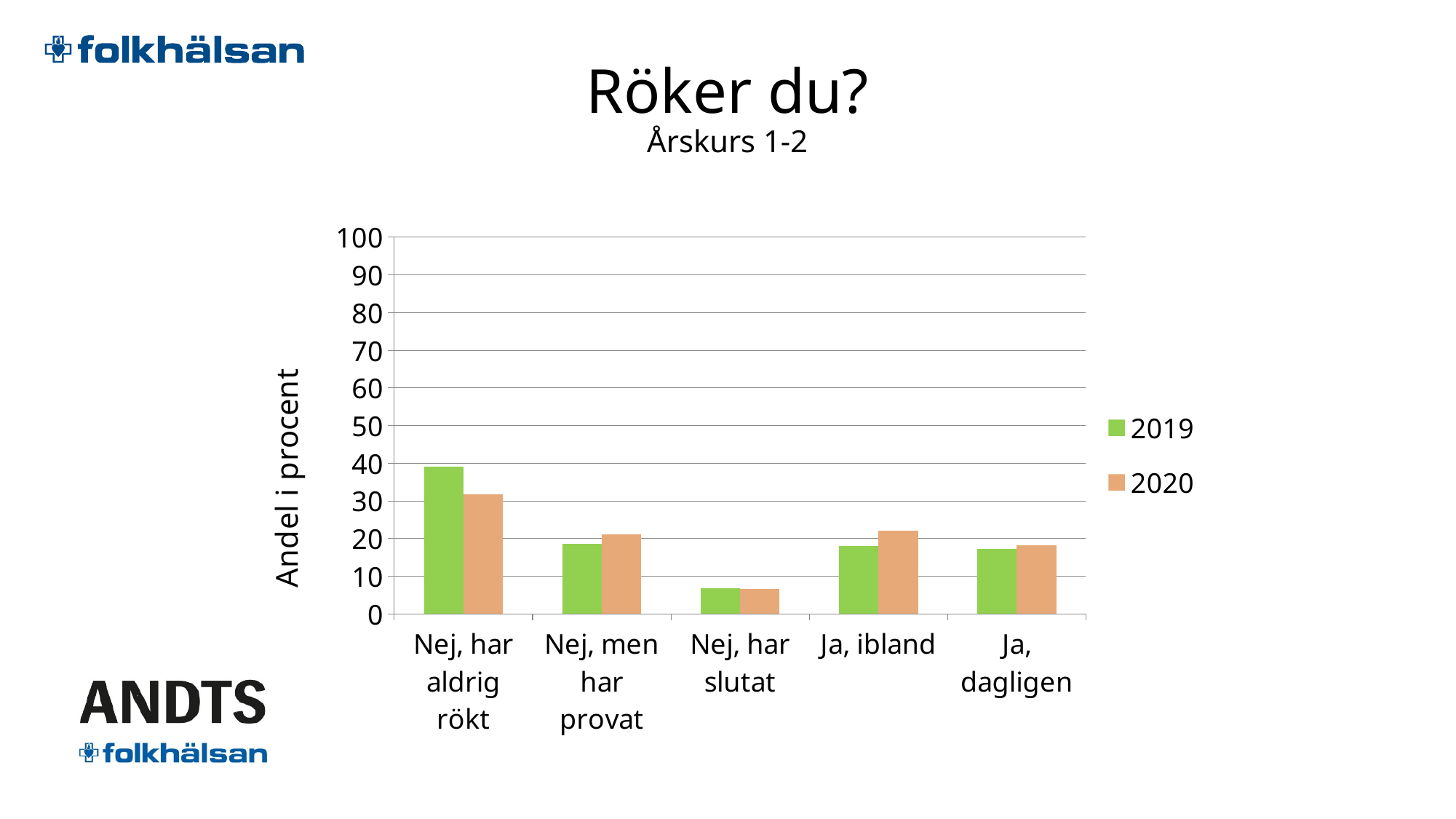
How many response categories are shown on the x axis? 5 What is the label on the y axis? Andel i procent What is the title of the chart? Röker du? Which category has the highest value for 2019? Nej, har aldrig rökt Is the 2019 value for 'Nej, har slutat' greater or less than 10? less Is the 2019 value for 'Nej, har aldrig rökt' greater or less than 30? greater For 'Ja, ibland', which year has the larger value, 2019 or 2020? 2020 Which category has the lowest value for 2020? Nej, har slutat How many series does the legend list? 2 For 'Nej, har aldrig rökt', which year has the larger value, 2019 or 2020? 2019 Is the 2020 value for 'Nej, har aldrig rökt' greater or less than 40? less What kind of chart is shown on the slide? bar chart